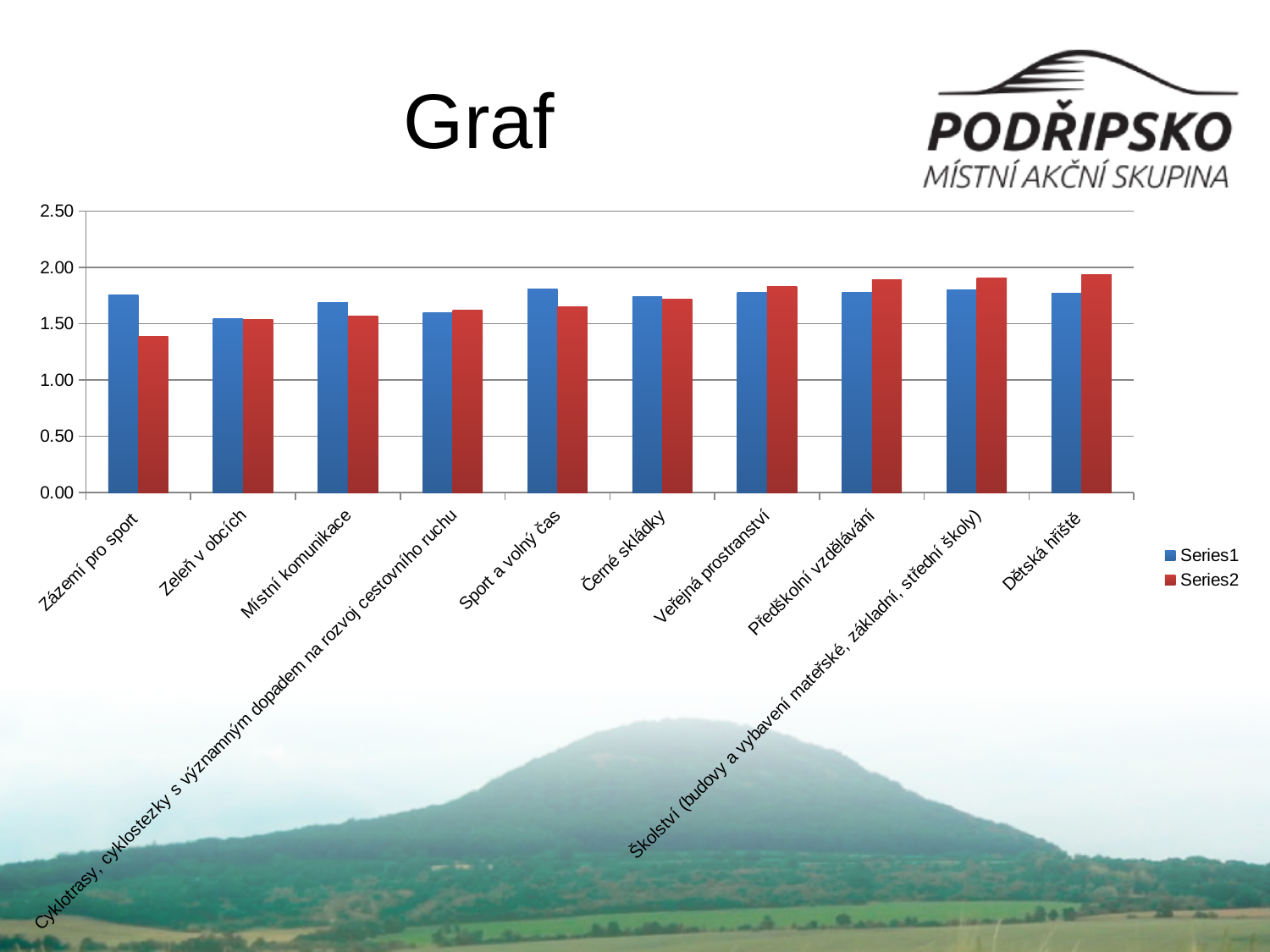
For Dětská hřiště, which series has the larger value, Series1 or Series2? Series2 For Zázemí pro sport, which series has the larger value, Series1 or Series2? Series1 For Sport a volný čas, which series has the larger value, Series1 or Series2? Series1 What is the title of the slide containing the chart? Graf Is the Series1 value for Zázemí pro sport greater or less than 1.50? greater How many categories are shown on the x axis of the chart? 10 Is the Series2 value for Zázemí pro sport greater or less than 1.50? less Which series is shown in red in the chart? Series2 Which category has the lowest Series2 value? Zázemí pro sport Is the Series2 value for Dětská hřiště greater or less than 2.00? less What kind of chart is shown on the slide? bar chart How many series does the chart's legend list? 2